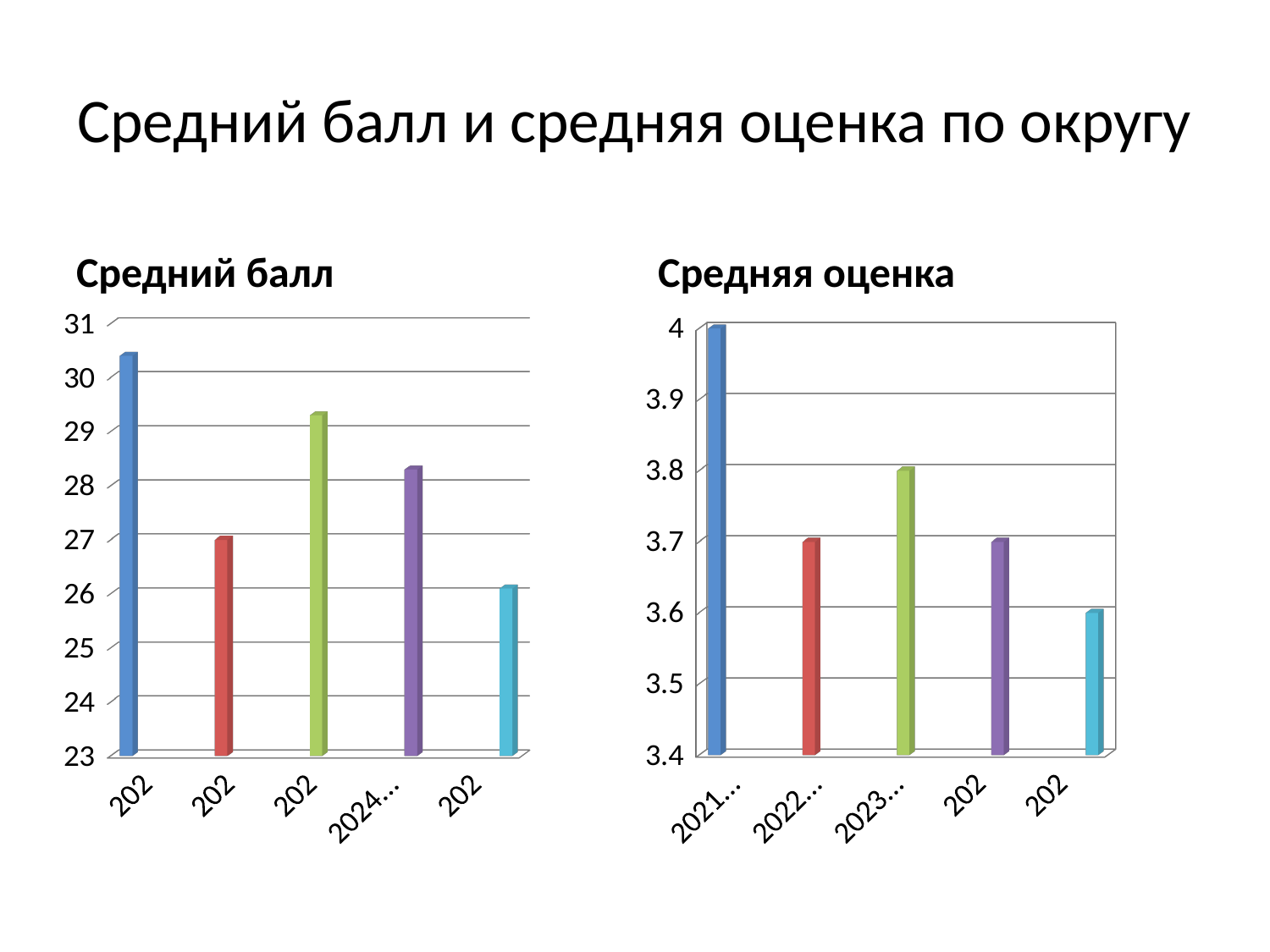
How many bars are plotted in the left chart "Средний балл"? 5 In the right chart "Средняя оценка", which is larger: the second (red) bar or the third (green) bar? the third (green) bar In the left chart "Средний балл", is the value of the first (blue) bar greater or less than 30? greater In the left chart "Средний балл", which bar is the lowest? the last (light blue) bar In the right chart "Средняя оценка", what is the value of the third (green) bar? 3.8 What kind of chart is the left chart titled "Средний балл"? bar chart In the right chart "Средняя оценка", what is the value of the first (blue) bar? 4 How many bars are plotted in the right chart "Средняя оценка"? 5 In the right chart "Средняя оценка", what is the difference between the first (blue) bar and the last (light blue) bar? 0.4 In the left chart "Средний балл", which bar is the highest? the first (blue) bar In the left chart "Средний балл", is the value of the fourth (purple) bar greater or less than 29? less In the right chart "Средняя оценка", what is the value of the last (light blue) bar? 3.6